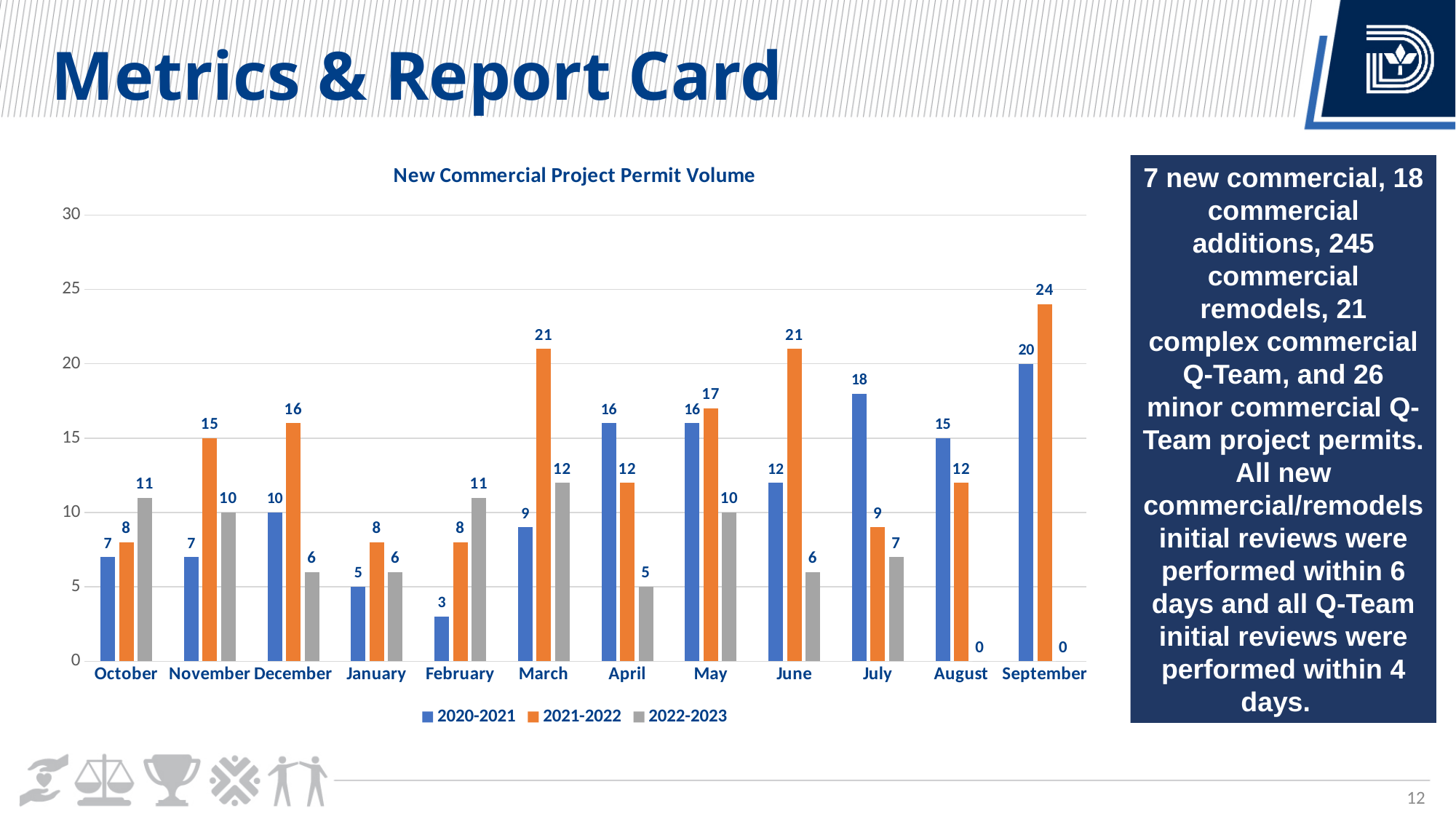
What is the value for 2022-2023 in February? 11 What is the title of the chart? New Commercial Project Permit Volume What is the value for 2020-2021 in July? 18 In April, which series has the larger value, 2020-2021 or 2022-2023? 2020-2021 What is the value for 2022-2023 in August? 0 What is the value for 2021-2022 in March? 21 What is the difference between the 2021-2022 and 2020-2021 values in September? 4 How many series does the legend list? 3 In which month is the 2020-2021 value lowest? February What type of chart is shown on the slide? bar chart In which month is the 2021-2022 value highest? September How many months are shown on the x axis? 12